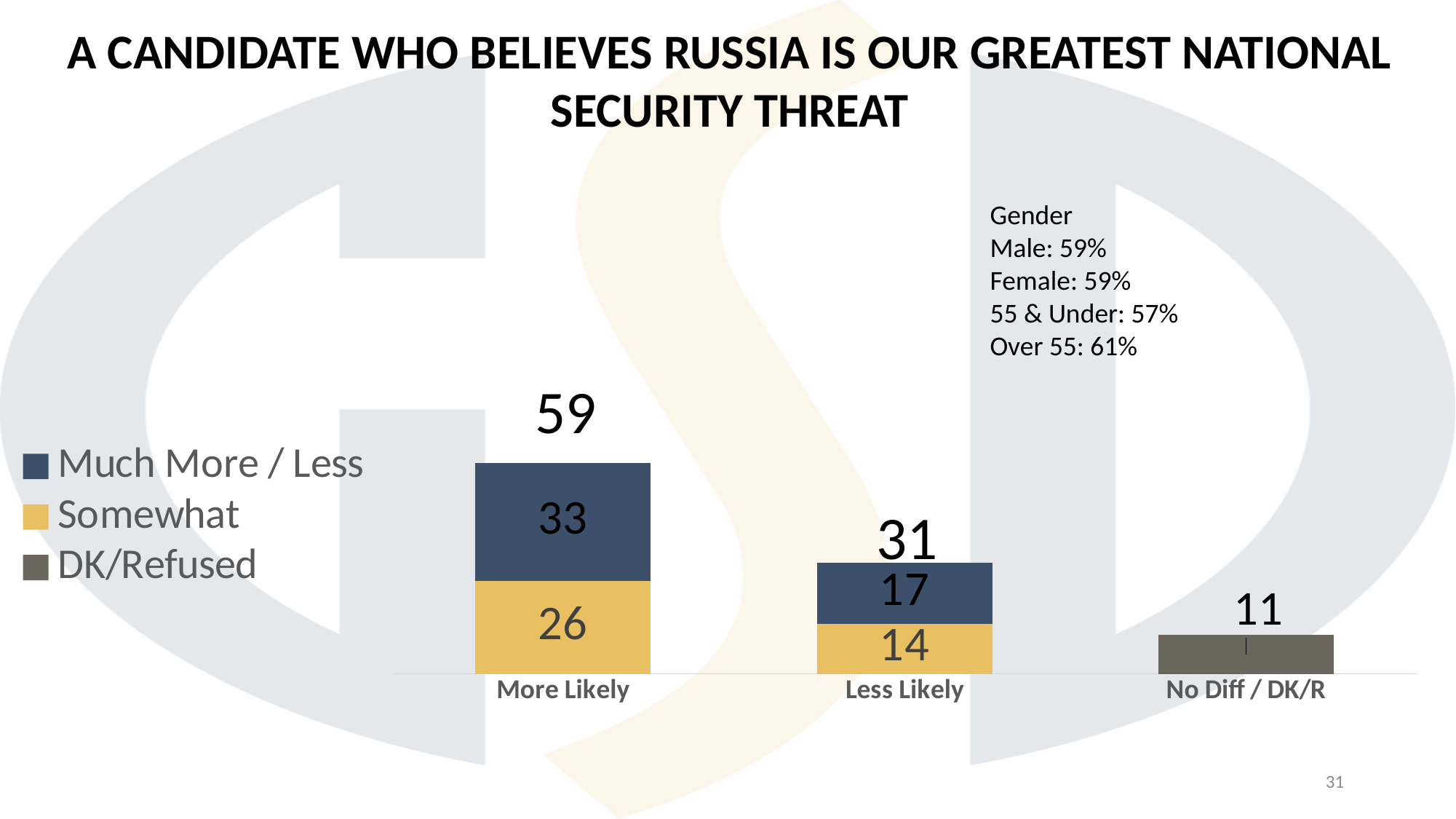
What is the total of the Less Likely stacked bar? 31 Which category has the highest total? More Likely What is the total of the More Likely stacked bar? 59 What is the 'Somewhat' value for the Less Likely bar? 14 What is the value shown for No Diff / DK/R? 11 How many categories are shown on the x axis? 3 Which category has the lowest total? No Diff / DK/R What is the difference between the More Likely total and the Less Likely total? 28 Which is larger: the 'Somewhat' value for More Likely or the 'Much More / Less' value for Less Likely? Somewhat for More Likely What is the 'Much More / Less' value for the More Likely bar? 33 How many series does the legend list? 3 What kind of chart is shown on the slide? Stacked bar chart